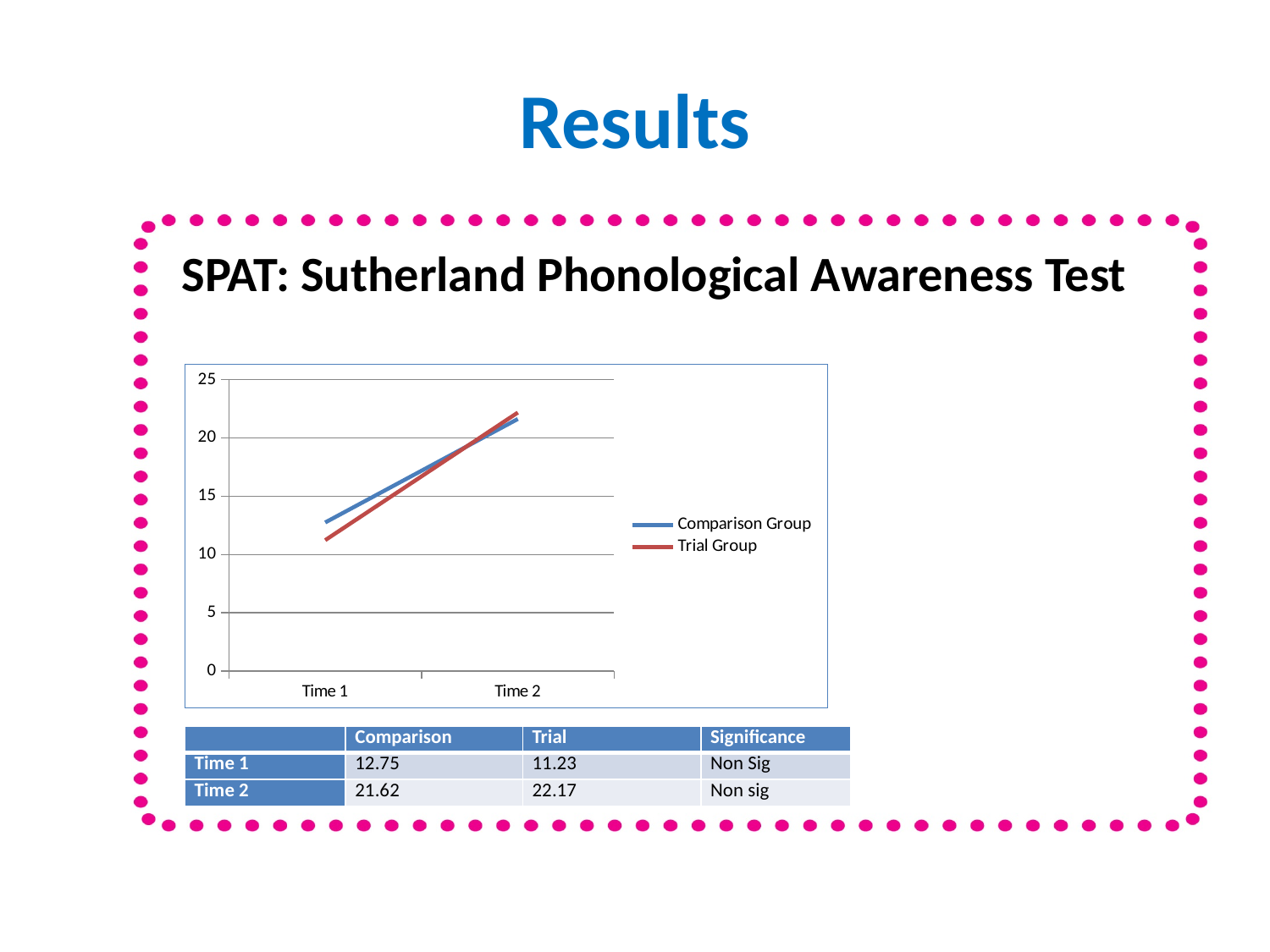
Is the Comparison Group value at Time 1 greater or less than 10? greater According to the table below the chart, what is the Trial Group value at Time 1? 11.23 How many series does the chart's legend list? 2 How many time points are plotted along the x axis of the chart? 2 According to the table below the chart, what is the Trial Group value at Time 2? 22.17 According to the table below the chart, what is the Comparison Group value at Time 1? 12.75 What are the two series named in the chart's legend? Comparison Group and Trial Group What kind of chart is shown on the slide? Line chart Which colour is used for the Trial Group line in the chart? Red Do the values for both groups rise or fall from Time 1 to Time 2? Rise Using the values in the table, what is the difference between the Trial Group's Time 2 and Time 1 values? 10.94 Using the values in the table, what is the difference between the Comparison Group's Time 2 and Time 1 values? 8.87